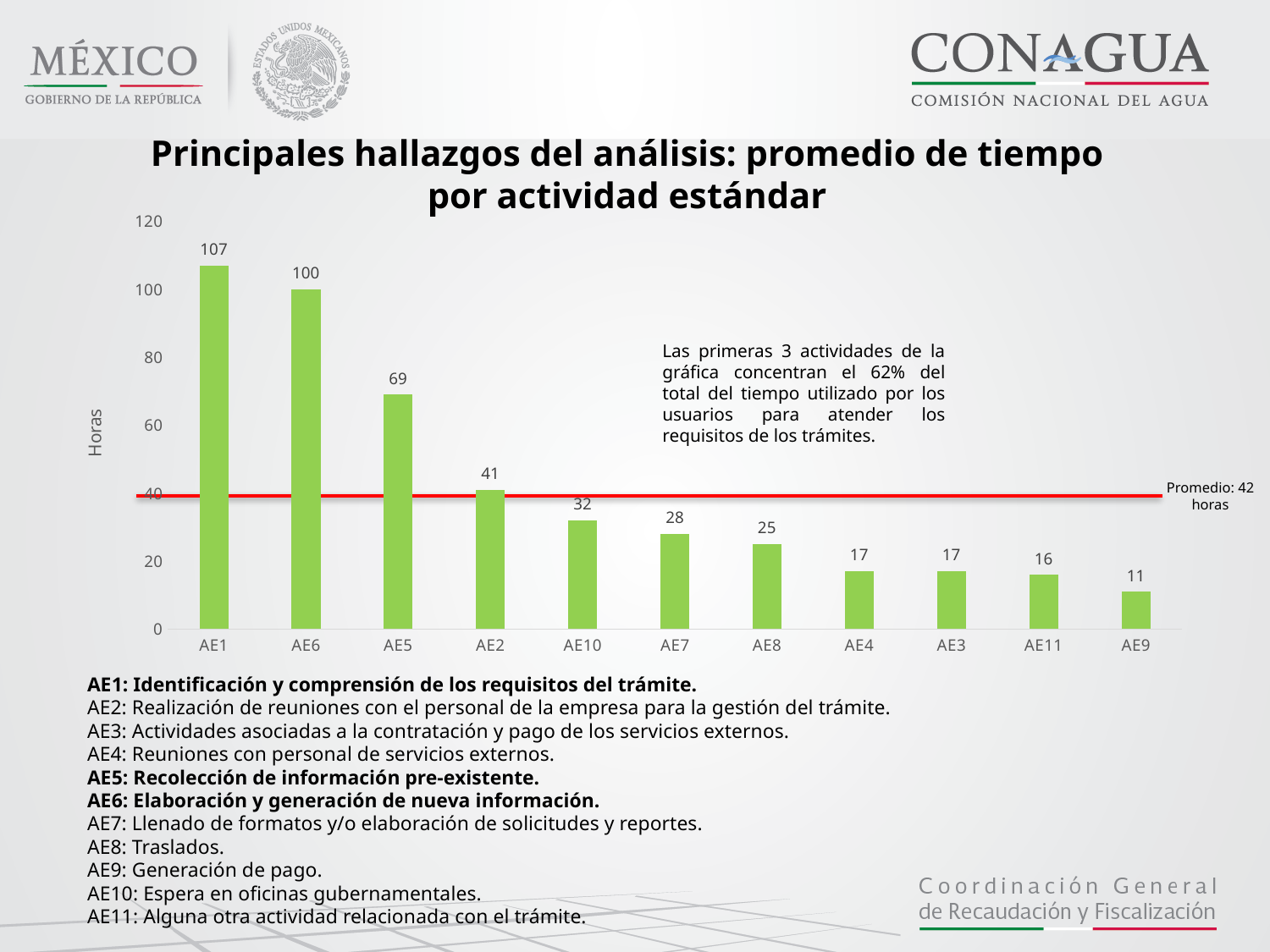
What is the value for AE10? 32 Do the bar values rise or fall from left to right along the x axis? Fall Which category has the highest value? AE1 Which is larger, the value for AE7 or the value for AE8? AE7 What is the difference between the values for AE1 and AE6? 7 What kind of chart is shown on the slide? Bar chart What average value does the red horizontal line represent? 42 horas What is the value for AE9? 11 What is the value for AE1? 107 Which category has the lowest value? AE9 What is the difference between the values for AE5 and AE2? 28 How many categories are shown on the x axis? 11